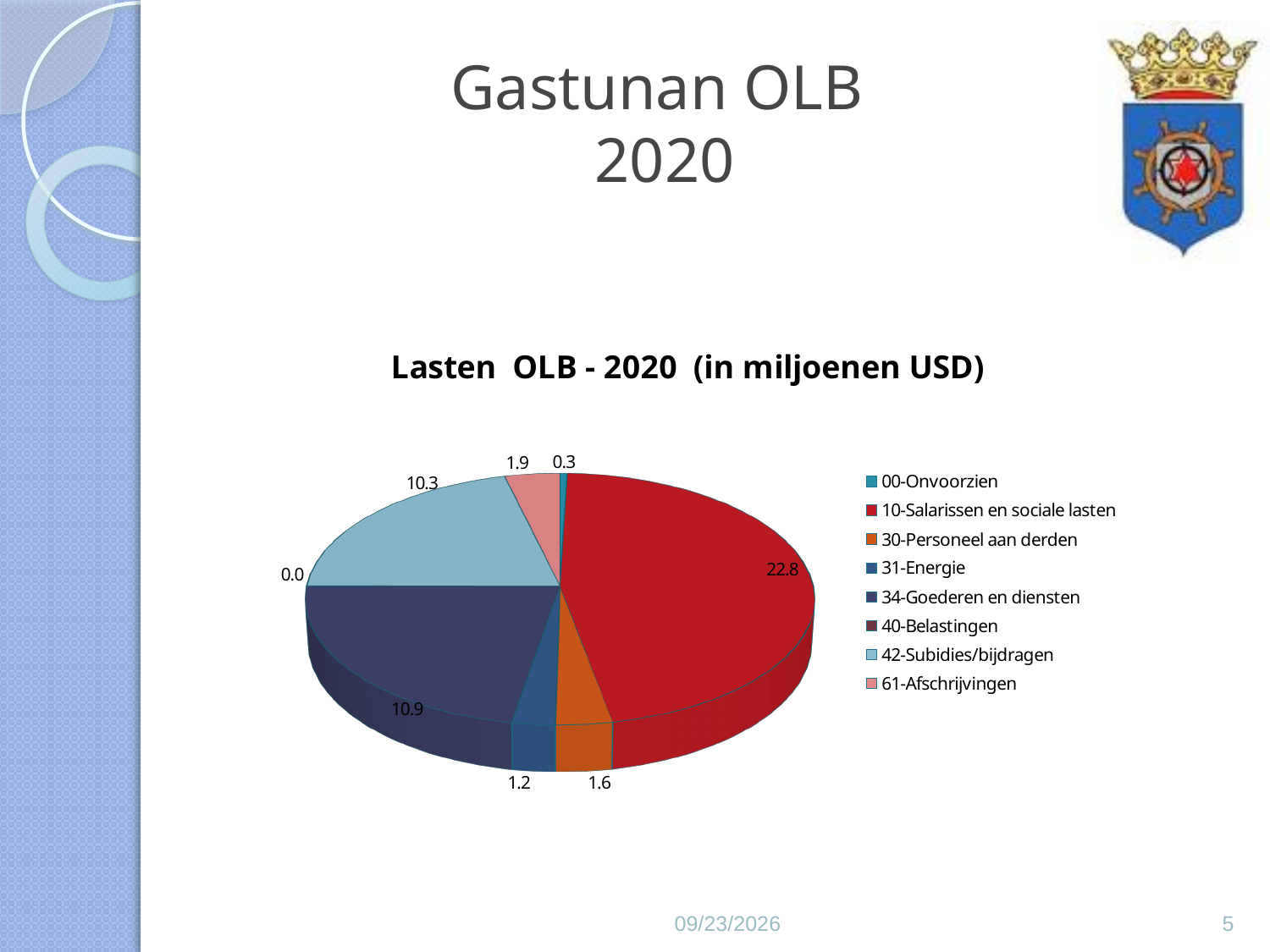
Which category has the smallest value? 40-Belastingen Which category has the largest slice of the pie? 10-Salarissen en sociale lasten What is the title of the chart? Lasten OLB - 2020 (in miljoenen USD) What is the value for 61-Afschrijvingen? 1.9 What is the difference between the values for 10-Salarissen en sociale lasten and 34-Goederen en diensten? 11.9 What is the value for 31-Energie? 1.2 How many categories does the legend list? 8 What kind of chart is shown on the slide? Pie chart What is the value for 42-Subidies/bijdragen? 10.3 What is the value for 10-Salarissen en sociale lasten? 22.8 Which is larger, 34-Goederen en diensten or 42-Subidies/bijdragen? 34-Goederen en diensten What is the value for 34-Goederen en diensten? 10.9